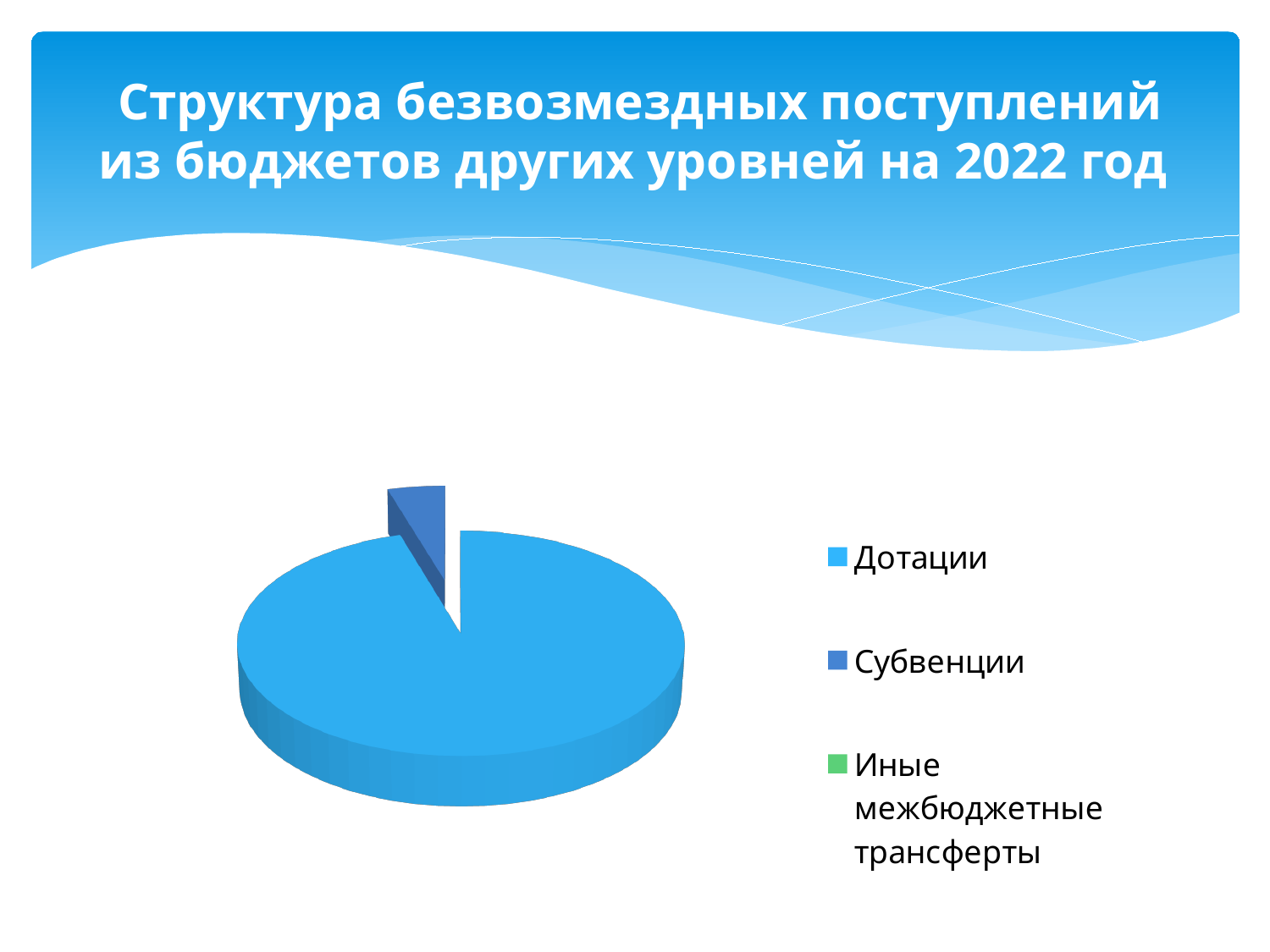
Does the slice for Дотации take up more or less than half of the pie? more Which year does the chart refer to? 2022 What is the title of the slide? Структура безвозмездных поступлений из бюджетов других уровней на 2022 год How many entries does the legend list? 3 What kind of chart is shown on the slide? Pie chart Which category has the largest slice of the pie? Дотации Which is larger, the slice for Дотации or the slice for Субвенции? Дотации Which legend entry is shown in green? Иные межбюджетные трансферты